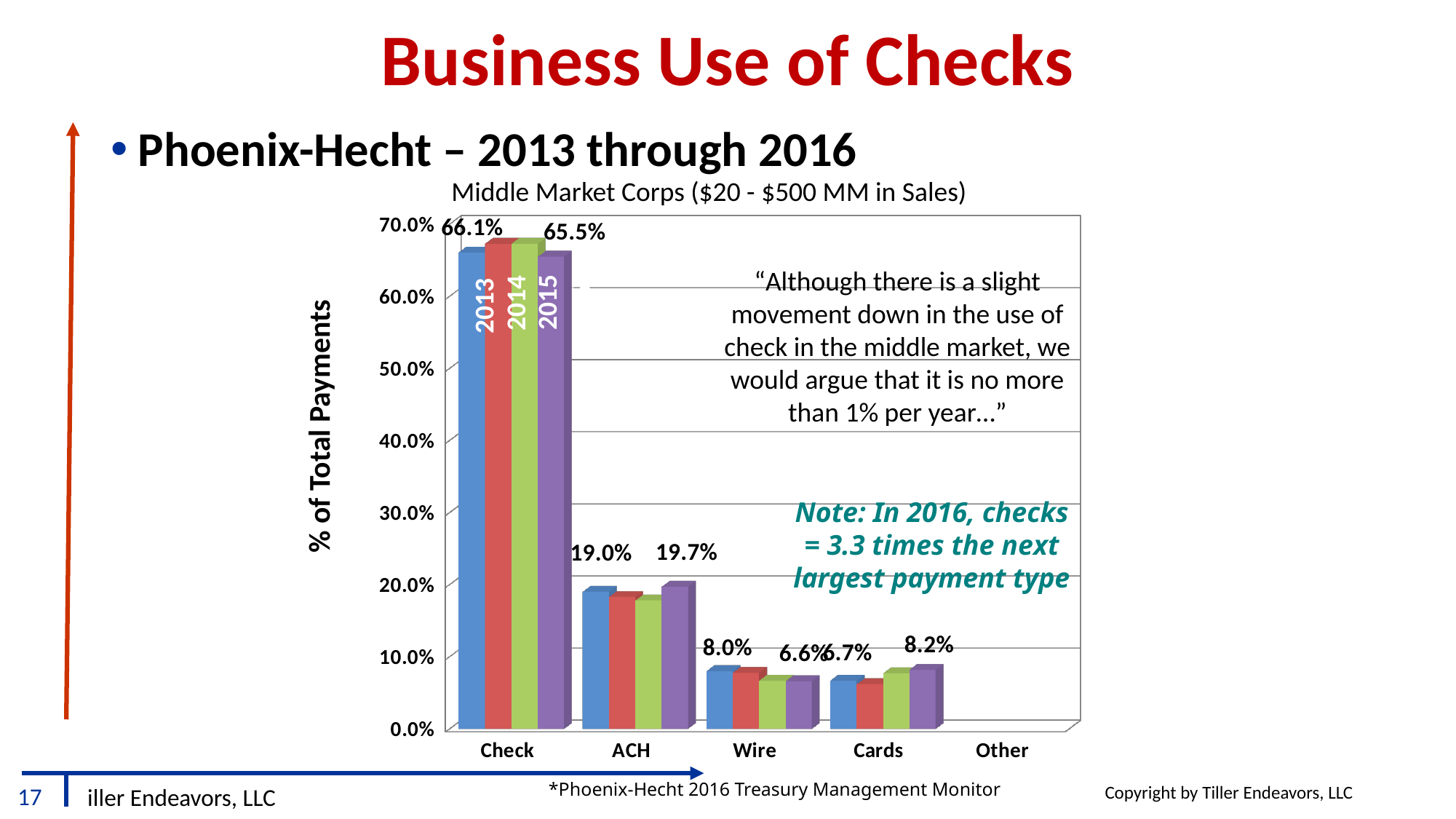
Which payment type has the highest share of total payments in the chart? Check What is the value labelled on the rightmost (purple) bar for ACH? 19.7% What is the 2013 value for ACH in the chart? 19.0% What is the title of the y axis in the chart? % of Total Payments How many payment-type categories are shown on the x axis of the chart? 5 Is the 2014 value for Check greater or less than 60%? greater What kind of chart is shown on the slide? Bar chart What is the 2013 value for Wire in the chart? 8.0% What is the value labelled on the rightmost (purple) bar for Check? 65.5% What is the value labelled on the rightmost (purple) bar for Cards? 8.2% What is the difference between the 2013 Check value (66.1%) and the rightmost Check value (65.5%)? 0.6 percentage points What is the 2013 value for Check in the chart? 66.1%